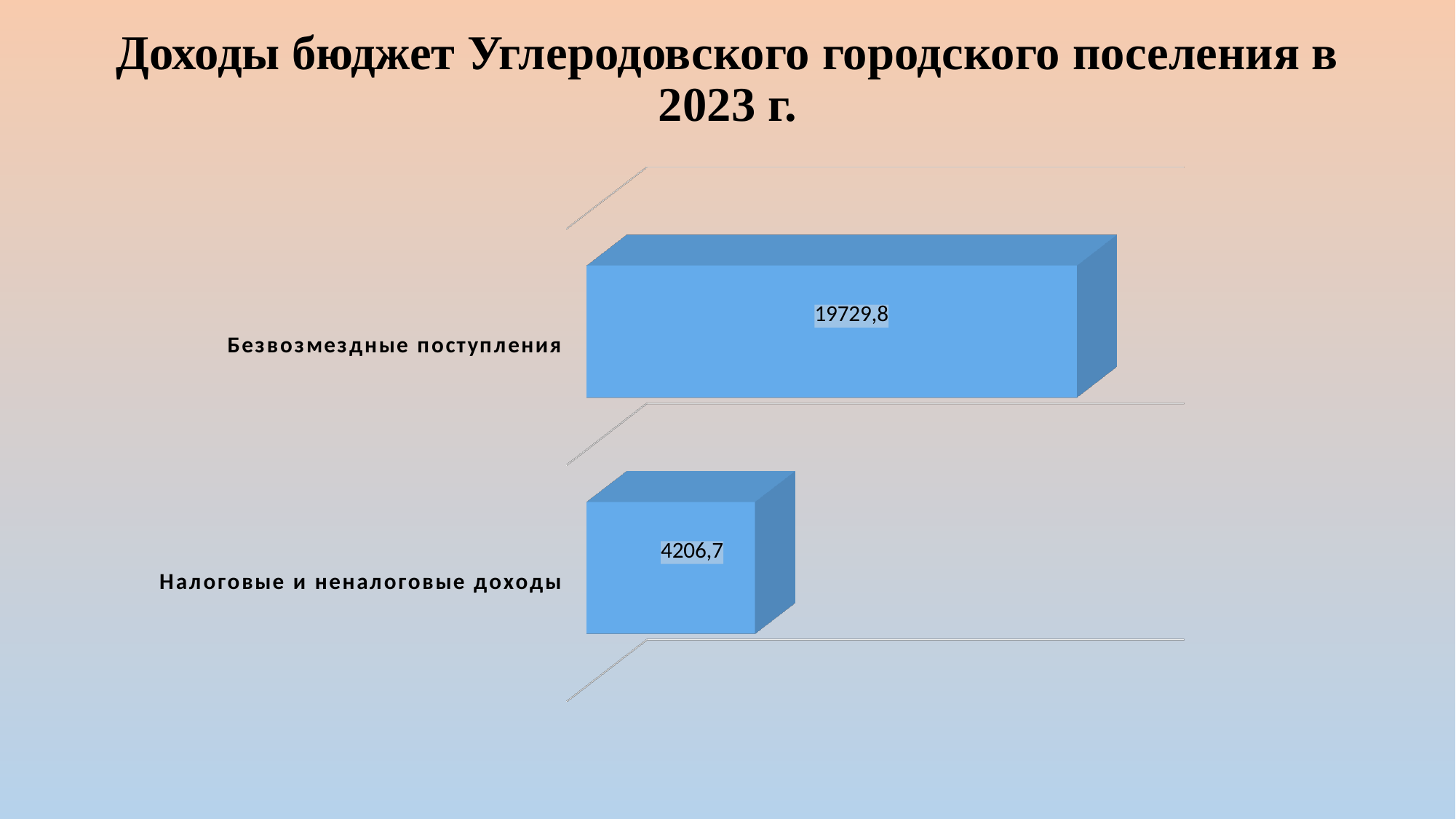
What is the title of the slide? Доходы бюджет Углеродовского городского поселения в 2023 г. How many categories are shown in the chart? 2 Which category has the highest value? Безвозмездные поступления What is the difference between the values for Безвозмездные поступления and Налоговые и неналоговые доходы? 15523,1 What is the sum of the two values shown in the chart? 23936,5 What kind of chart is shown on the slide? Bar chart Which category has the lowest value? Налоговые и неналоговые доходы Which is larger: the value for Безвозмездные поступления or the value for Налоговые и неналоговые доходы? Безвозмездные поступления What is the value for Налоговые и неналоговые доходы? 4206,7 What colour are the bars in the chart? Blue What is the value for Безвозмездные поступления? 19729,8